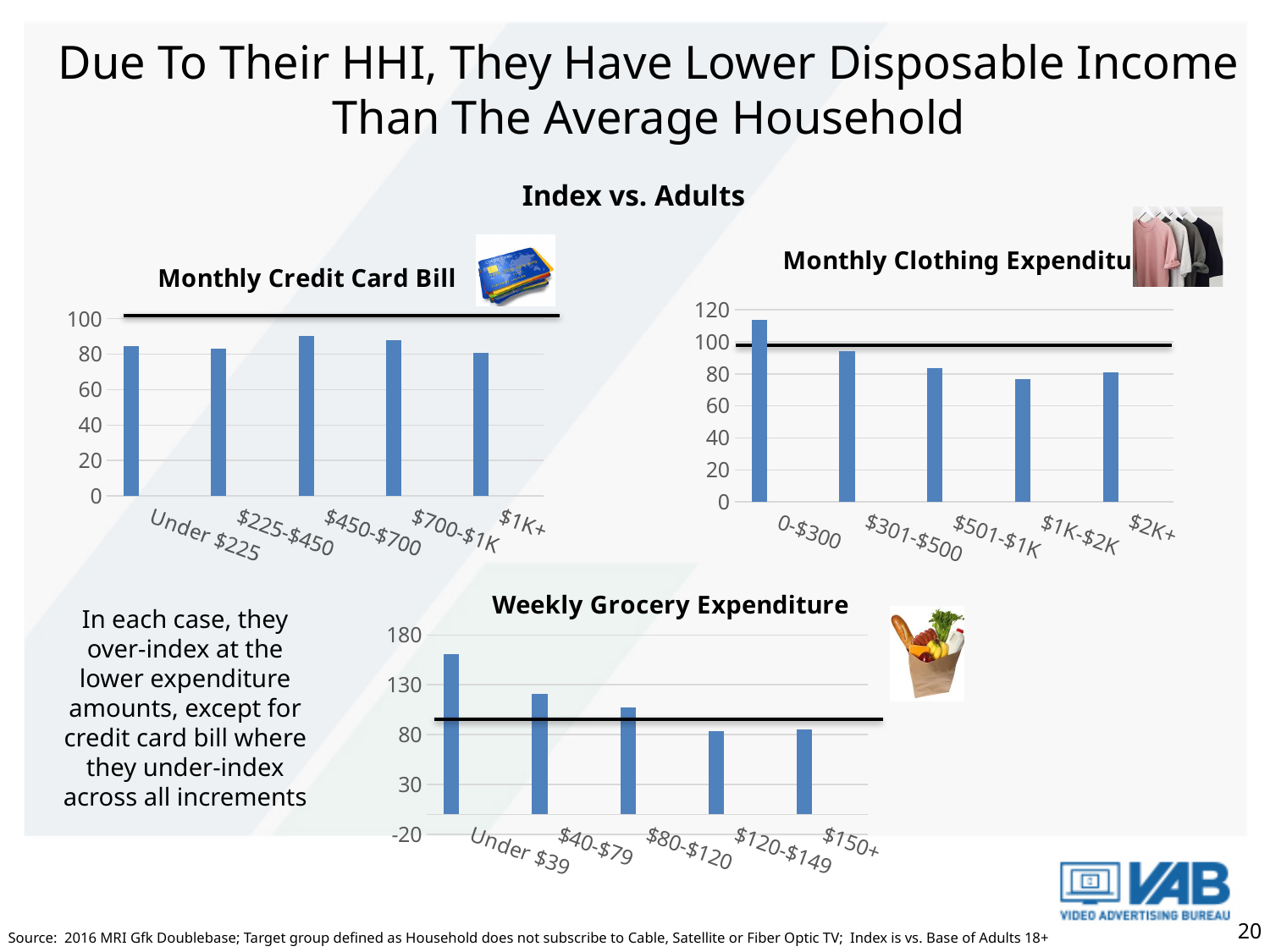
On the Monthly Clothing Expenditure chart, which is larger, the value for $501-$1K or the value for $1K-$2K? $501-$1K On the Weekly Grocery Expenditure chart, which category has the highest bar? Under $39 What is the title of the chart in the bottom half of the slide? Weekly Grocery Expenditure On the Monthly Clothing Expenditure chart, is the value for $301-$500 greater or less than 100? less How many categories are shown on the Monthly Credit Card Bill chart? 5 On the Monthly Clothing Expenditure chart, is the value for 0-$300 greater or less than 100? greater What kind of chart is the Weekly Grocery Expenditure chart? bar chart On the Monthly Credit Card Bill chart, is the value for Under $225 greater or less than 100? less On the Monthly Clothing Expenditure chart, which category has the highest bar? 0-$300 On the Weekly Grocery Expenditure chart, do the values generally rise or fall from Under $39 to $150+? fall On the Monthly Credit Card Bill chart, which category has the highest bar? $450-$700